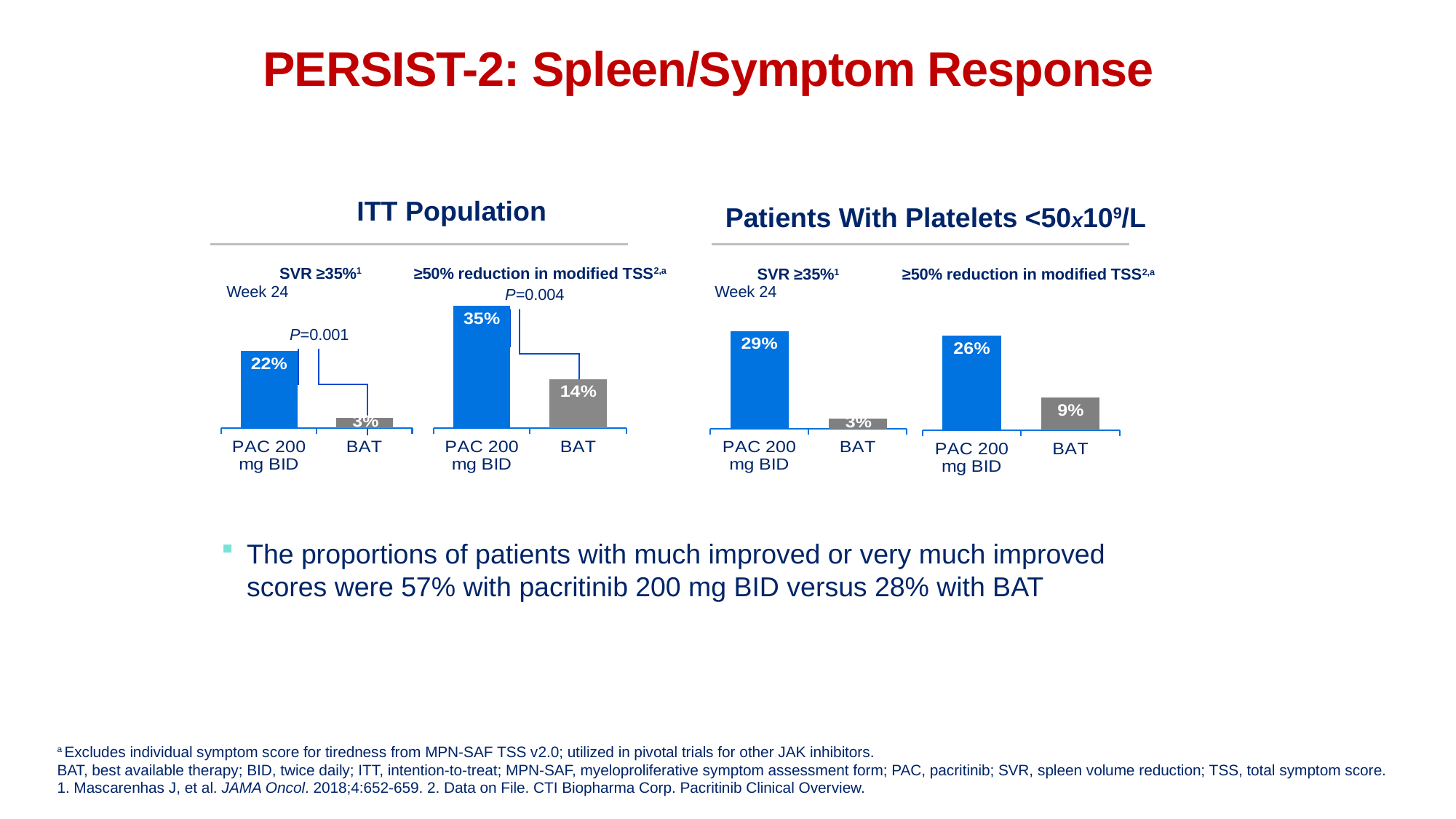
In the ITT Population SVR ≥35% chart, what is the value for BAT? 3% In the Patients With Platelets <50x10⁹/L ≥50% reduction in modified TSS chart, which category has the higher value, PAC 200 mg BID or BAT? PAC 200 mg BID In the ITT Population ≥50% reduction in modified TSS chart, what is the value for BAT? 14% In the ITT Population ≥50% reduction in modified TSS chart, what is the value for PAC 200 mg BID? 35% In the ITT Population ≥50% reduction in modified TSS chart, what is the difference between PAC 200 mg BID and BAT? 21% In the Patients With Platelets <50x10⁹/L ≥50% reduction in modified TSS chart, what is the value for BAT? 9% How many categories are shown in the ITT Population SVR ≥35% chart? 2 What type of chart is used for the ITT Population SVR ≥35% data? Bar chart In the Patients With Platelets <50x10⁹/L SVR ≥35% chart, what is the value for PAC 200 mg BID? 29% In the ITT Population SVR ≥35% chart, what is the value for PAC 200 mg BID? 22% In the Patients With Platelets <50x10⁹/L SVR ≥35% chart, what is the difference between PAC 200 mg BID and BAT? 26% In the ITT Population SVR ≥35% chart, which category has the lowest value? BAT